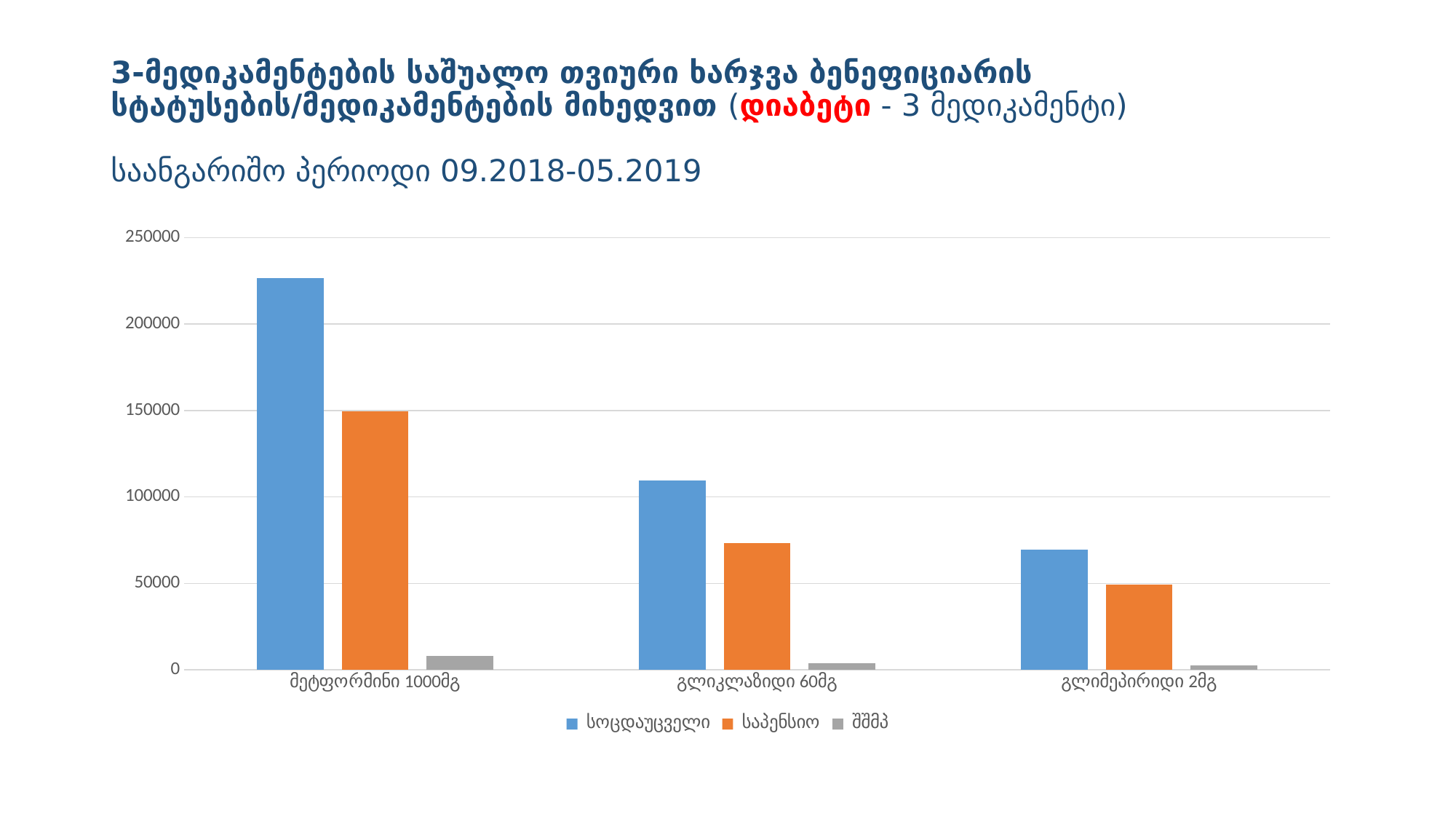
How many categories are shown on the x axis of the chart? 3 How many series does the chart legend list? 3 Is the სოცდაუცველი value for მეტფორმინი 1000მგ greater or less than 200000? greater Which colour represents the საპენსიო series in the chart? orange Is the საპენსიო value for გლიკლაზიდი 60მგ greater or less than 100000? less Is the სოცდაუცველი value for გლიკლაზიდი 60მგ greater or less than 100000? greater Do the სოცდაუცველი values rise or fall from left to right across the categories? fall Which is larger for გლიმეპირიდი 2მგ: the სოცდაუცველი value or the საპენსიო value? სოცდაუცველი Which category has the lowest value for the შშმპ series? გლიმეპირიდი 2მგ Which category has the highest value for the სოცდაუცველი series? მეტფორმინი 1000მგ What kind of chart is shown on the slide? bar chart